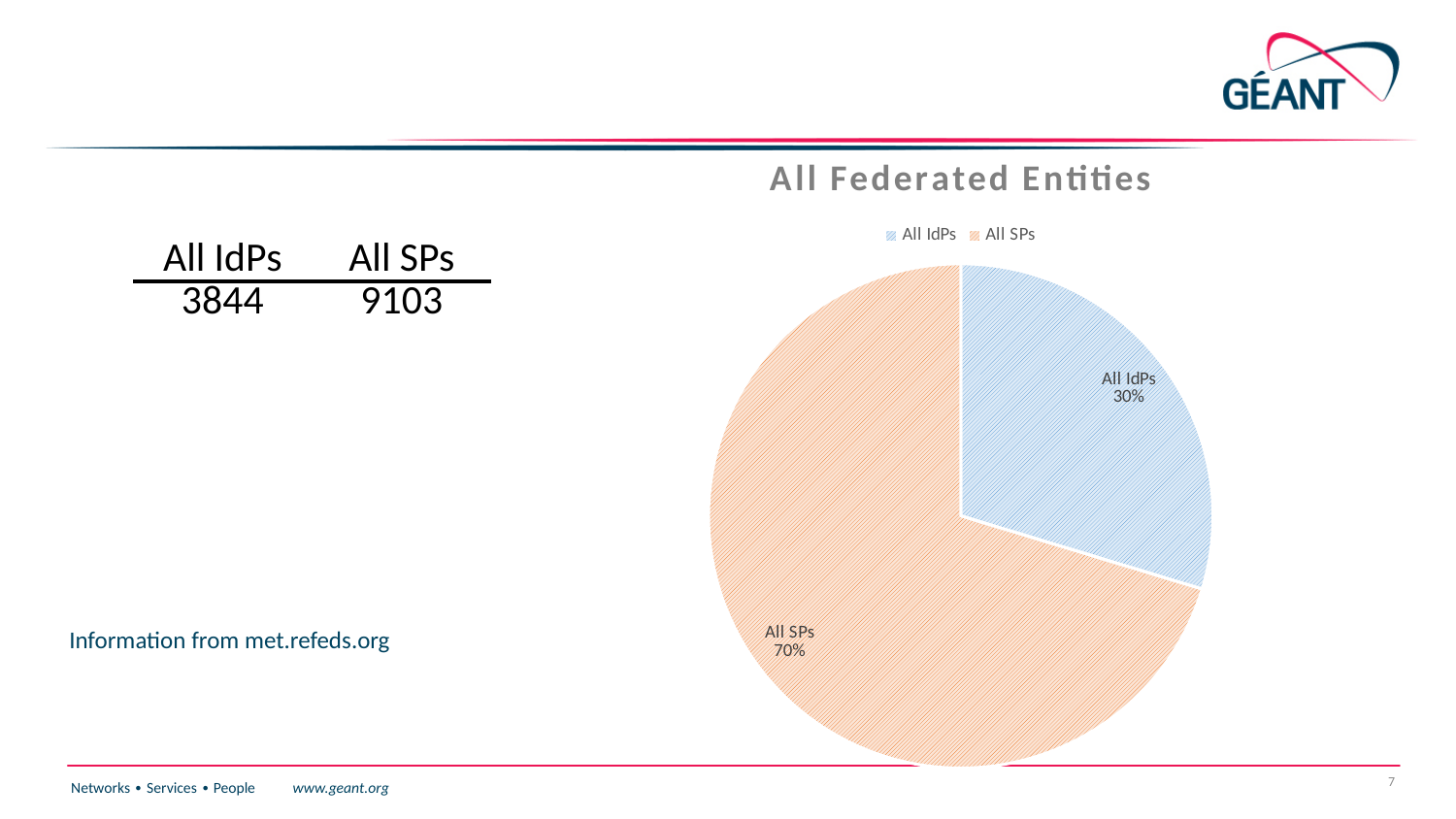
What share of the pie does All SPs represent? 70% How many entries does the chart's legend list? 2 How many slices does the pie chart have? 2 Which slice of the pie chart is the smallest? All IdPs Which is larger in the pie chart, All IdPs or All SPs? All SPs What is the title of the chart? All Federated Entities What are the two legend entries of the chart? All IdPs and All SPs Which slice of the pie chart is the largest? All SPs By how many percentage points does the All SPs share exceed the All IdPs share? 40 percentage points What share of the pie does All IdPs represent? 30% What kind of chart is shown on the slide? pie chart